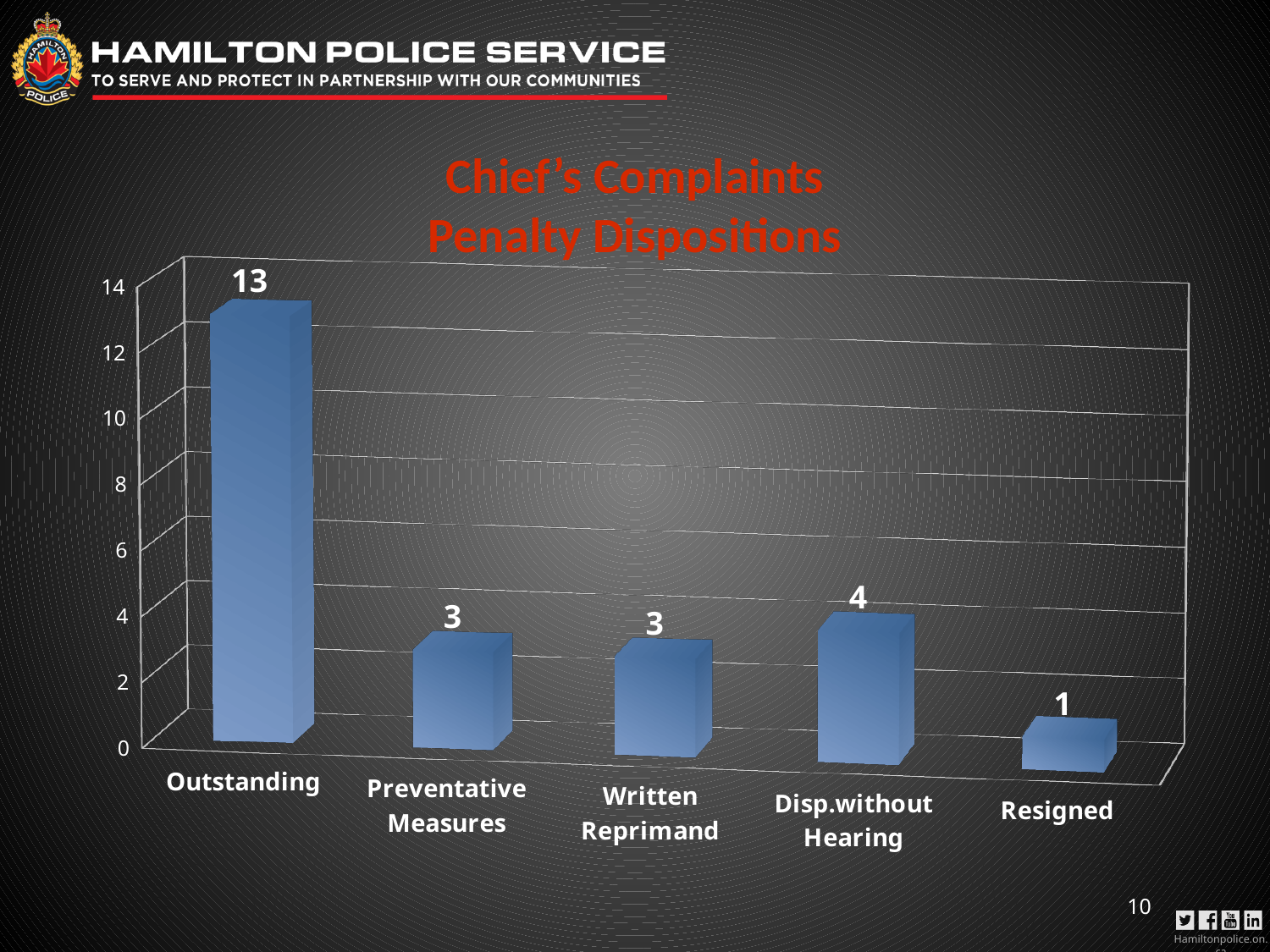
What is the value for Resigned? 1 Is the value for Outstanding greater or less than 12? greater What is the value for Disp.without Hearing? 4 What is the value for Preventative Measures? 3 What is the title of the chart? Chief's Complaints Penalty Dispositions Which category has the highest value? Outstanding Which category has the lowest value? Resigned Which is larger, the value for Disp.without Hearing or the value for Written Reprimand? Disp.without Hearing What kind of chart is shown on the slide? bar chart What is the value for Outstanding? 13 What is the difference between the values for Outstanding and Disp.without Hearing? 9 How many categories are shown on the x axis? 5